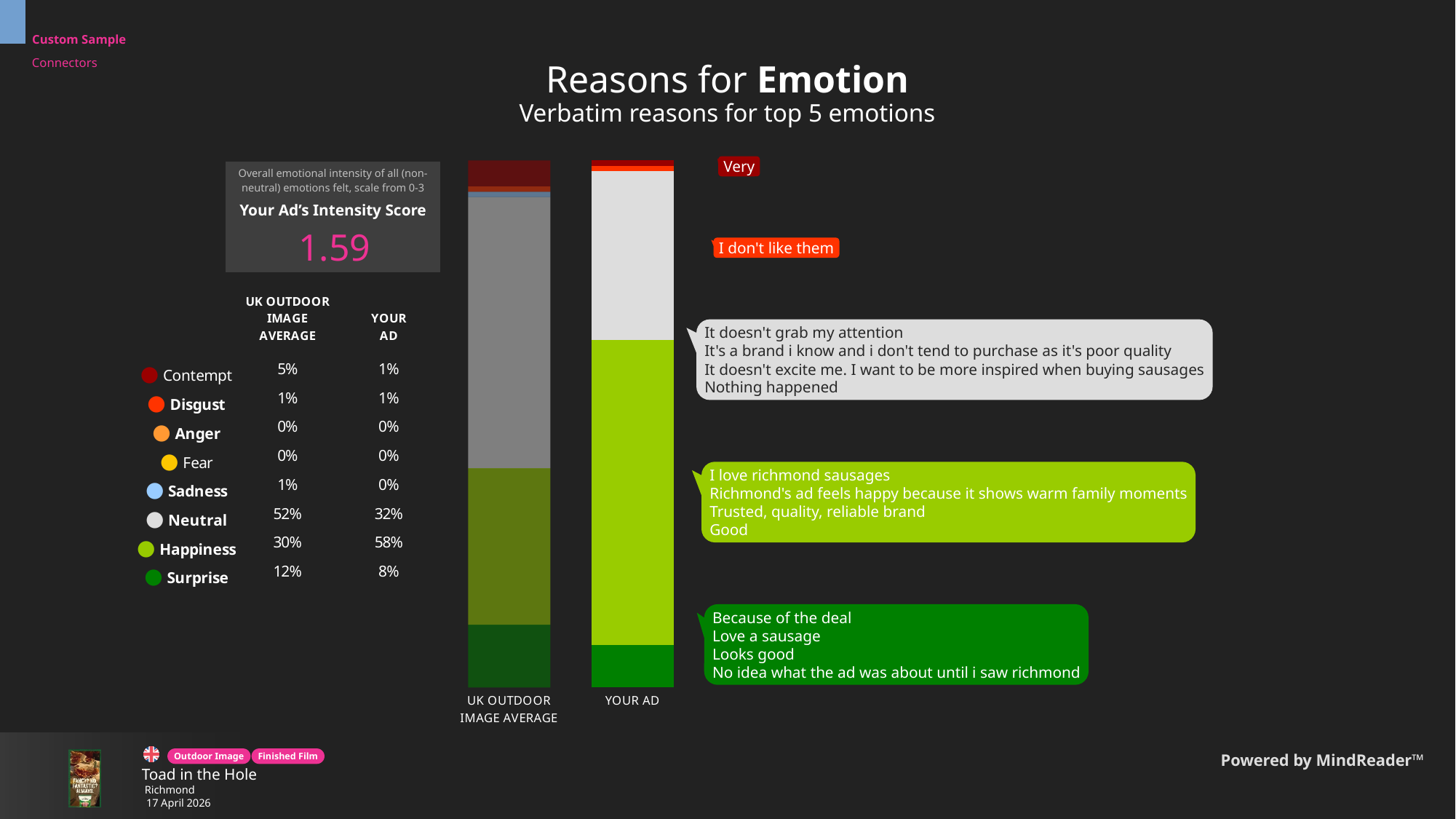
How many emotions does the legend list? 8 Which is larger: the Neutral value for the UK Outdoor Image Average or for Your Ad? UK Outdoor Image Average Which emotion has the largest share in the UK Outdoor Image Average bar? Neutral What is the Contempt value for Your Ad? 1% What kind of chart is shown on the slide? stacked bar chart What is the Happiness value for Your Ad? 58% Which emotion has the largest share in the Your Ad bar? Happiness How many bars are plotted in the chart? 2 What is the Neutral value for the UK Outdoor Image Average? 52% What is the difference between the Happiness value for Your Ad and for the UK Outdoor Image Average? 28% What is Your Ad's Intensity Score shown on the slide? 1.59 What is the Surprise value for the UK Outdoor Image Average? 12%